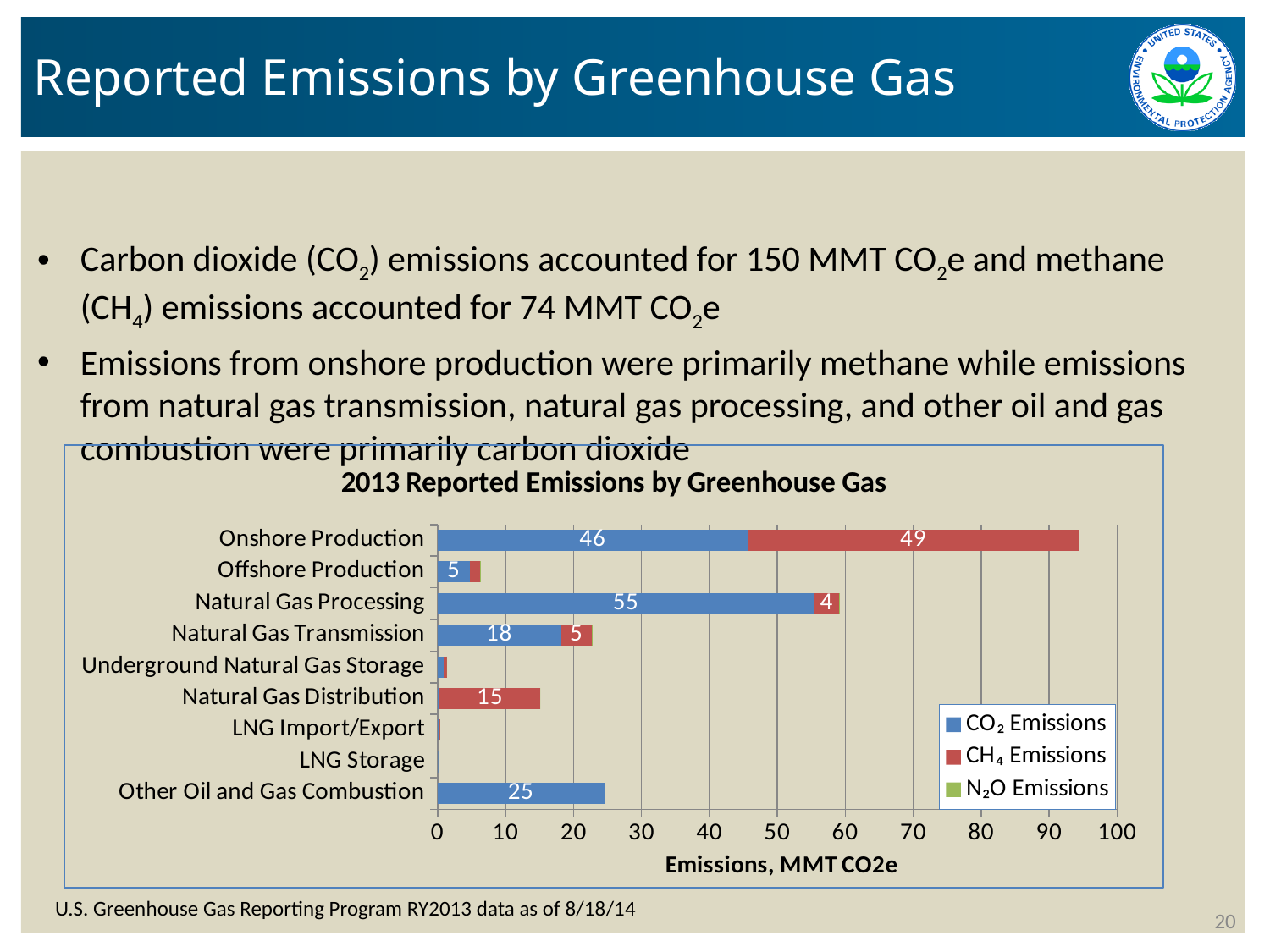
Is the total bar length for Onshore Production greater or less than 90? greater What is the CO₂ Emissions value for Other Oil and Gas Combustion? 25 Which category has the highest CH₄ Emissions value? Onshore Production What is the title of the chart? 2013 Reported Emissions by Greenhouse Gas Which category has the highest CO₂ Emissions value? Natural Gas Processing What type of chart is shown on the slide? Stacked horizontal bar chart How many series does the chart legend list? 3 What is the CH₄ Emissions value for Onshore Production? 49 What is the CO₂ Emissions value for Natural Gas Processing? 55 How many categories are shown on the chart's vertical axis? 9 What is the difference between the CO₂ Emissions values for Natural Gas Processing and Onshore Production? 9 What is the CH₄ Emissions value for Natural Gas Distribution? 15